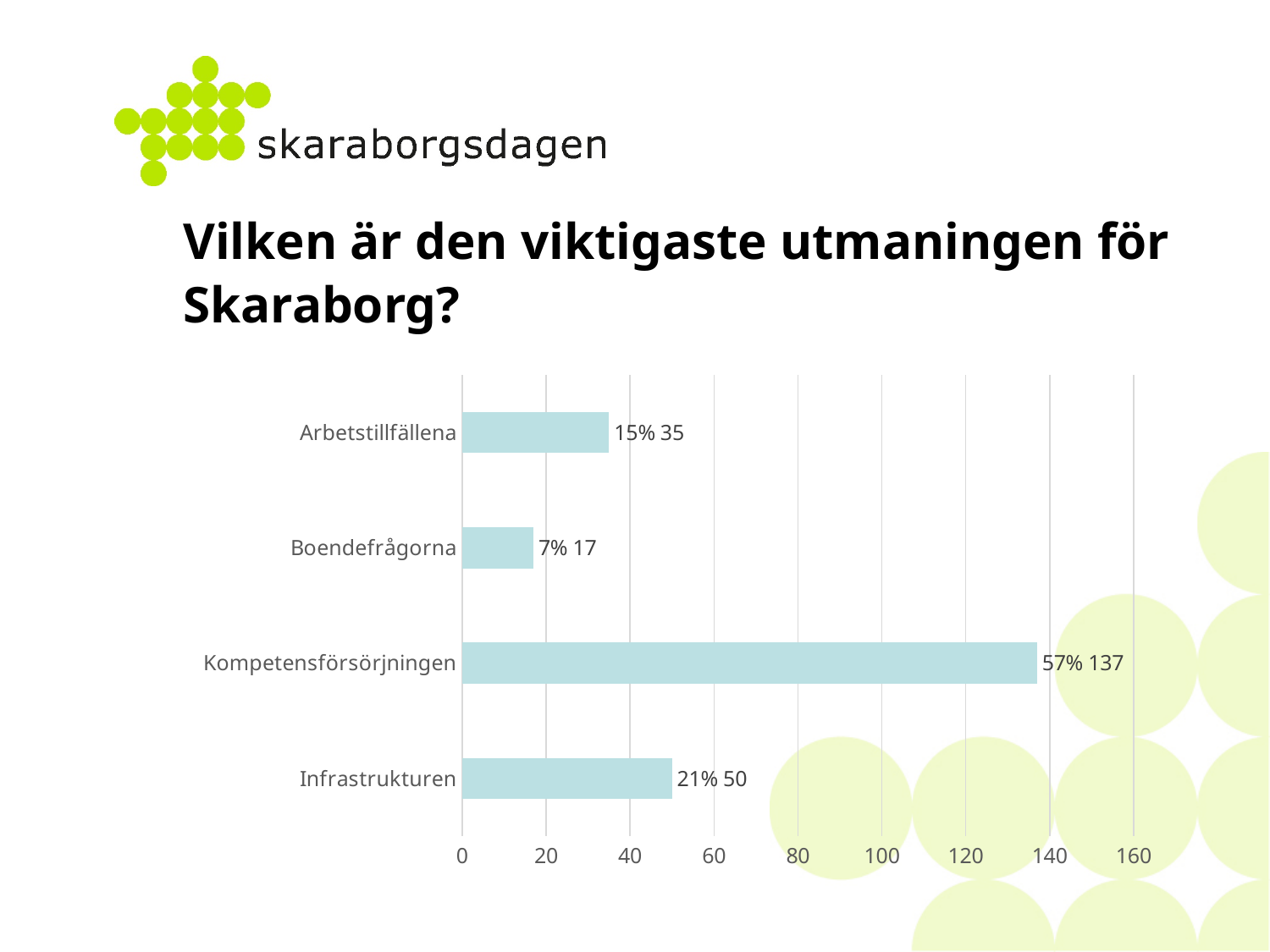
Which category has the lowest value? Boendefrågorna What kind of chart is shown on the slide? Bar chart Which has a larger value, Infrastrukturen or Arbetstillfällena? Infrastrukturen What is the difference in count between Kompetensförsörjningen and Infrastrukturen? 87 What is the count value for Boendefrågorna? 17 Which category has the highest value? Kompetensförsörjningen Is the value for Kompetensförsörjningen greater or less than 120? greater What percentage is shown for Arbetstillfällena? 15% What is the difference in count between Arbetstillfällena and Boendefrågorna? 18 How many categories are shown in the chart? 4 What percentage is shown for Infrastrukturen? 21% What is the count value for Kompetensförsörjningen? 137